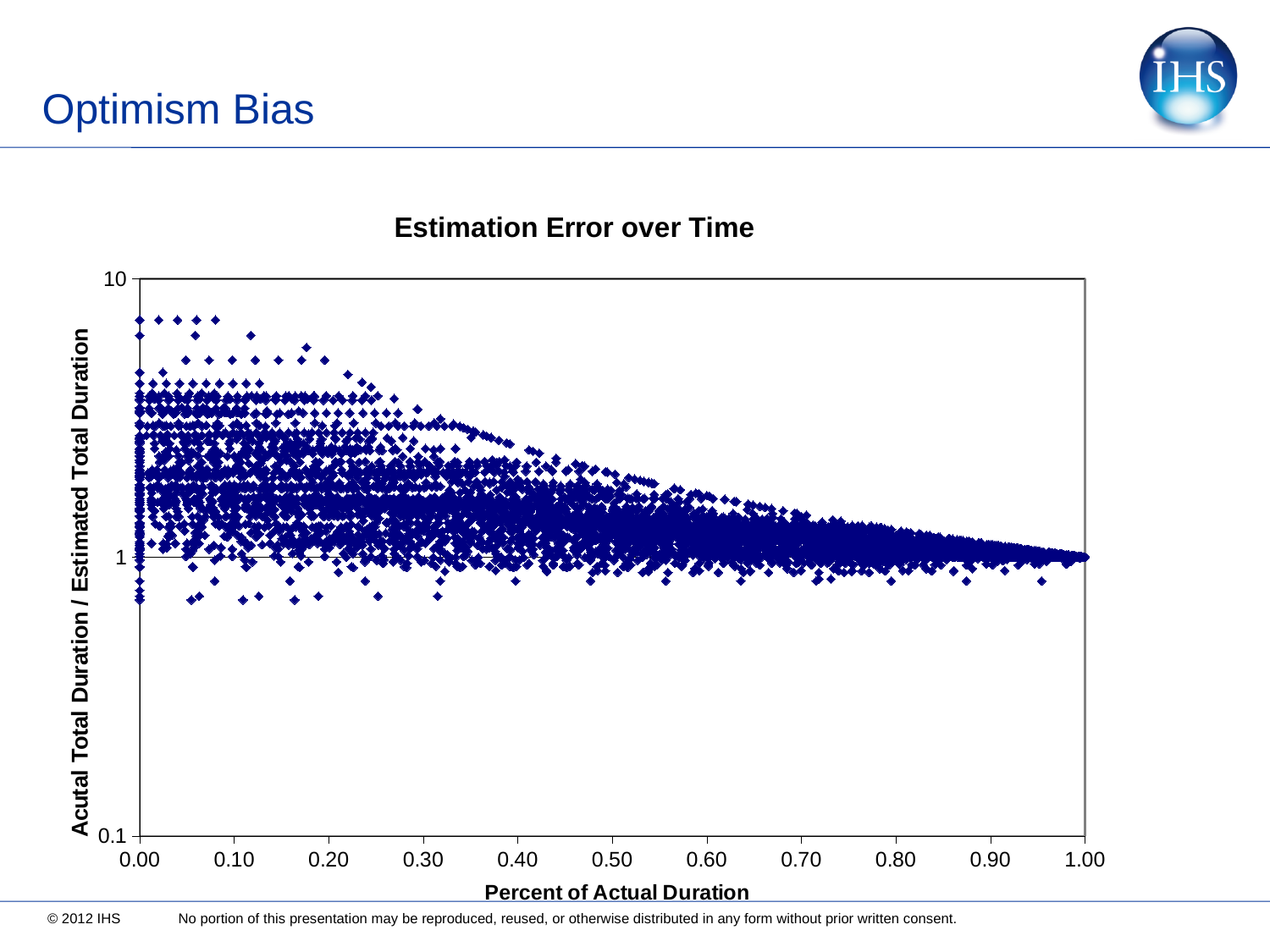
Do the plotted values generally rise or fall as Percent of Actual Duration increases along the x axis? Fall As Percent of Actual Duration increases toward 1.00, do the plotted values converge toward 1 or spread further apart? Converge toward 1 What is the label of the x axis of the chart? Percent of Actual Duration Are any plotted points below the y-axis value of 0.1? No What is the title of the chart? Estimation Error over Time What is the highest value shown on the y axis of the chart? 10 What kind of chart is shown on the slide? Scatter plot Are most of the plotted points above or below the y-axis value of 1? Above